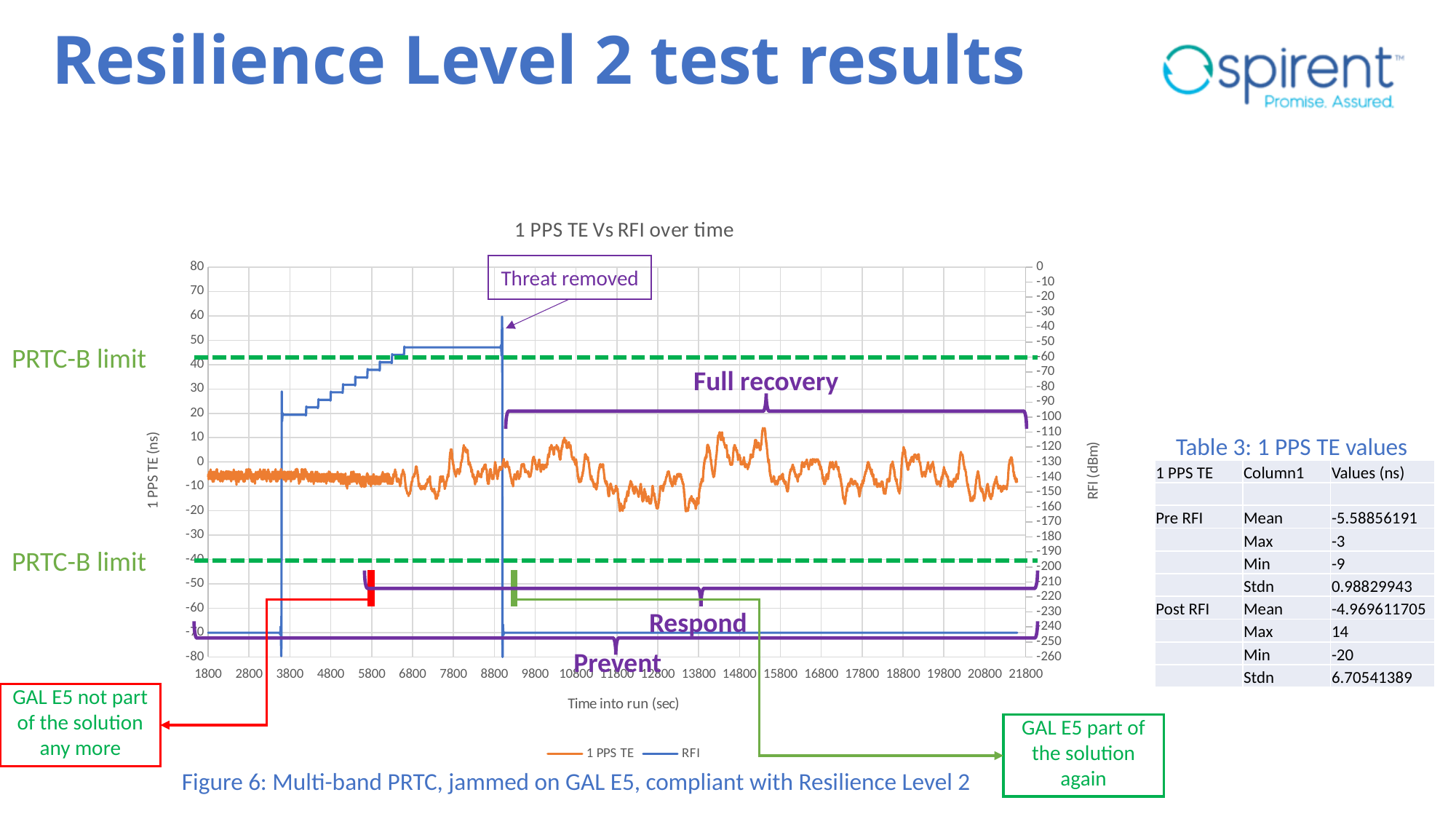
What is the title of the chart? 1 PPS TE Vs RFI over time What is the highest value shown on the x axis of the chart? 21800 How many tick labels are shown along the x axis of the chart? 21 Is the 1 PPS TE value at 1800 sec greater or less than 0? less What kind of chart is shown on the slide? line chart Does the RFI line rise or fall between 3800 sec and 8800 sec? rise How many series does the chart legend list? 2 Which series is drawn in orange in the chart? 1 PPS TE What is the maximum value shown on the left (1 PPS TE) axis? 80 Is the 1 PPS TE value at 13800 sec greater or less than 0? less What is the lowest value shown on the x axis of the chart? 1800 What is the lowest value shown on the right (RFI) axis? -260